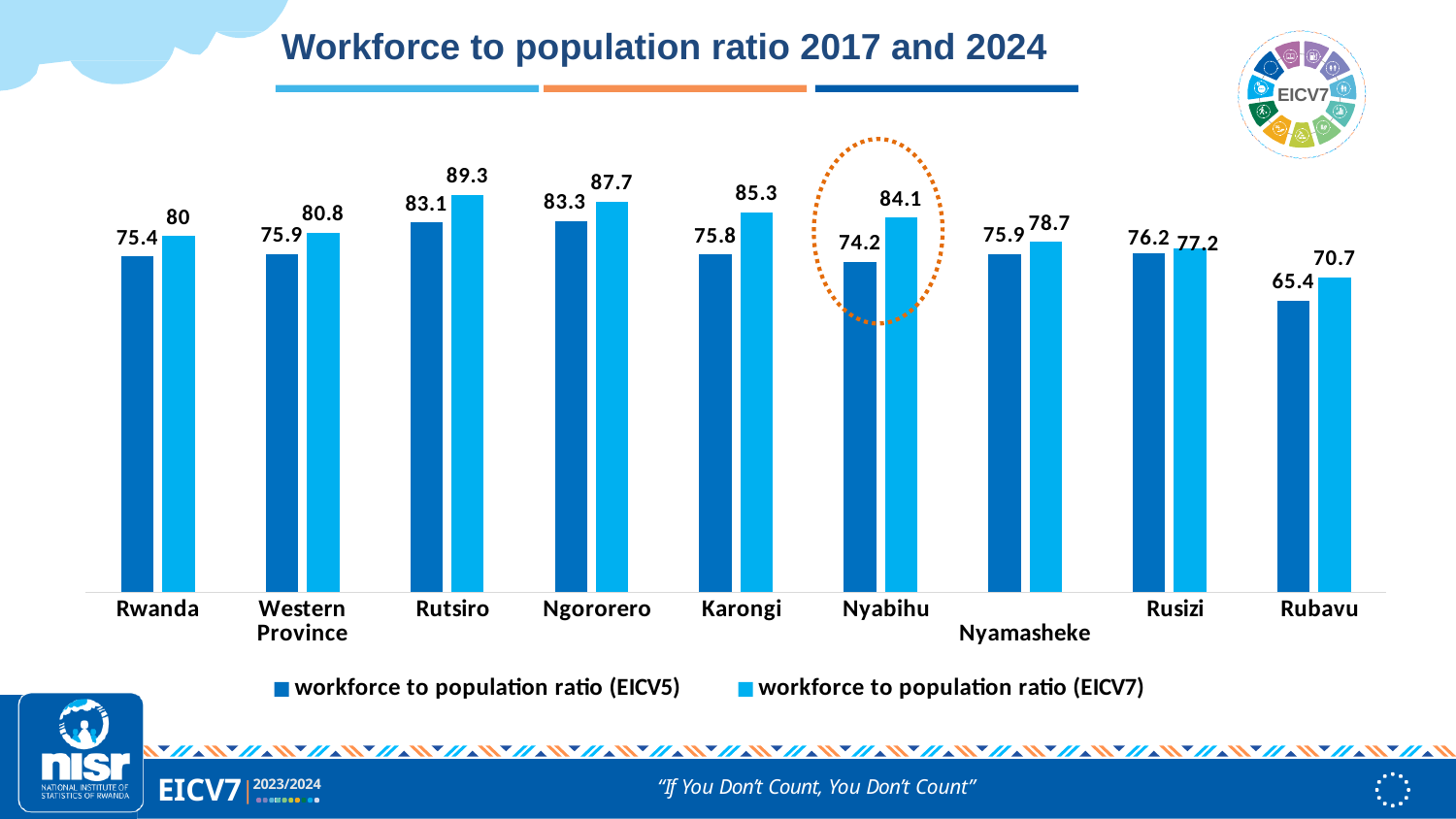
Which category is highlighted with a dotted orange circle? Nyabihu Which category has the highest workforce to population ratio (EICV7)? Rutsiro What is the difference between the EICV7 and EICV5 workforce to population ratios for Karongi? 9.5 What is the workforce to population ratio (EICV5) for Nyabihu? 74.2 Which is larger: the EICV7 workforce to population ratio for Ngororero or for Karongi? Ngororero Which category has the lowest workforce to population ratio (EICV5)? Rubavu What is the workforce to population ratio (EICV7) for Rutsiro? 89.3 What kind of chart is shown on the slide? Bar chart How many categories are shown on the x axis of the chart? 9 How many series does the legend list? 2 What is the difference between the EICV7 and EICV5 workforce to population ratios for Nyabihu? 9.9 What is the workforce to population ratio (EICV7) for Rwanda? 80